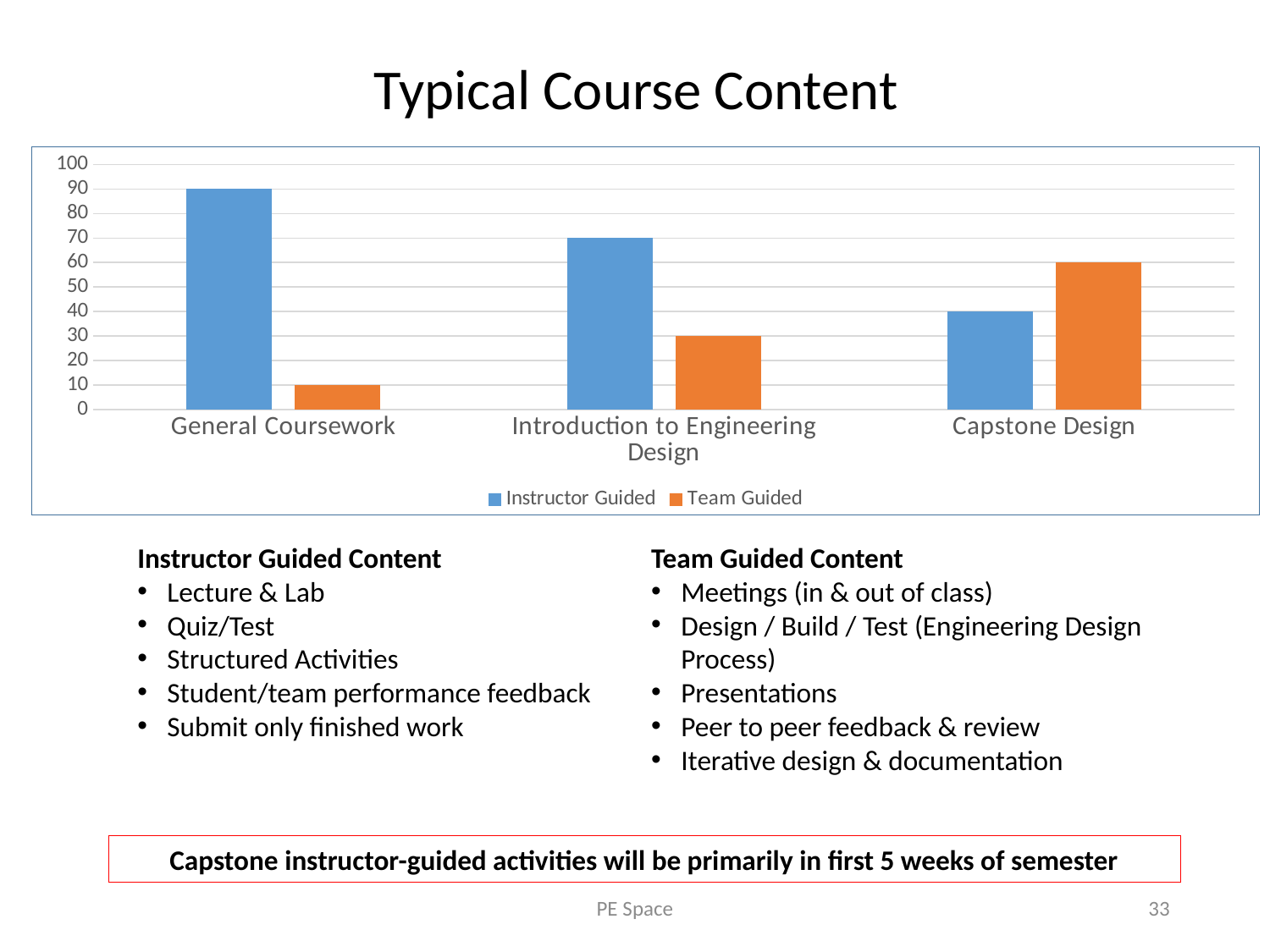
What is the difference between the Instructor Guided and Team Guided values for General Coursework? 80 For Capstone Design, which is larger: Instructor Guided or Team Guided? Team Guided How many categories are shown on the x axis? 3 What kind of chart is shown on the slide? bar chart Which category has the highest Instructor Guided value? General Coursework What is the Instructor Guided value for General Coursework? 90 Do the Instructor Guided values rise or fall from left to right across the categories? fall Which colour represents the Team Guided series in the legend? orange What is the Team Guided value for Capstone Design? 60 How many series does the legend list? 2 Which category has the lowest Team Guided value? General Coursework What is the Instructor Guided value for Introduction to Engineering Design? 70